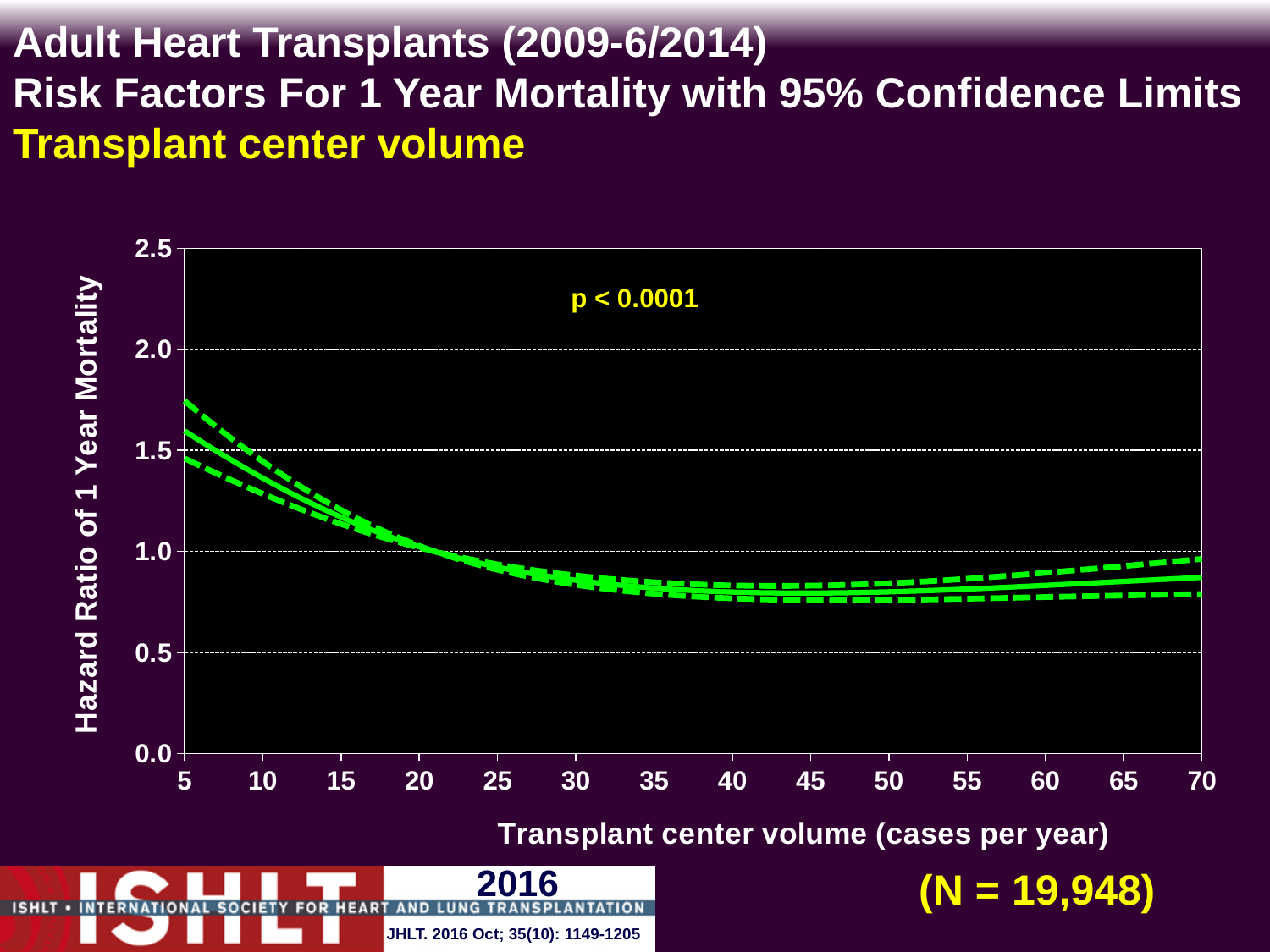
Is the hazard ratio at a transplant center volume of 60 cases per year greater or less than 1.0? less Is the hazard ratio at a transplant center volume of 30 cases per year greater or less than 1.0? less Does the hazard ratio rise or fall as transplant center volume increases from 5 to 40 cases per year? fall At which transplant center volume is the hazard ratio of 1 year mortality highest? 5 What p-value is printed on the chart? p < 0.0001 Is the hazard ratio at a transplant center volume of 10 cases per year greater or less than 1.0? greater What kind of chart is shown on the slide? line chart How many tick labels are shown on the x axis? 14 Which has the larger hazard ratio: a transplant center volume of 5 or 70 cases per year? 5 Which has the larger hazard ratio: a transplant center volume of 10 or 30 cases per year? 10 What is the sample size N shown on the slide? N = 19,948